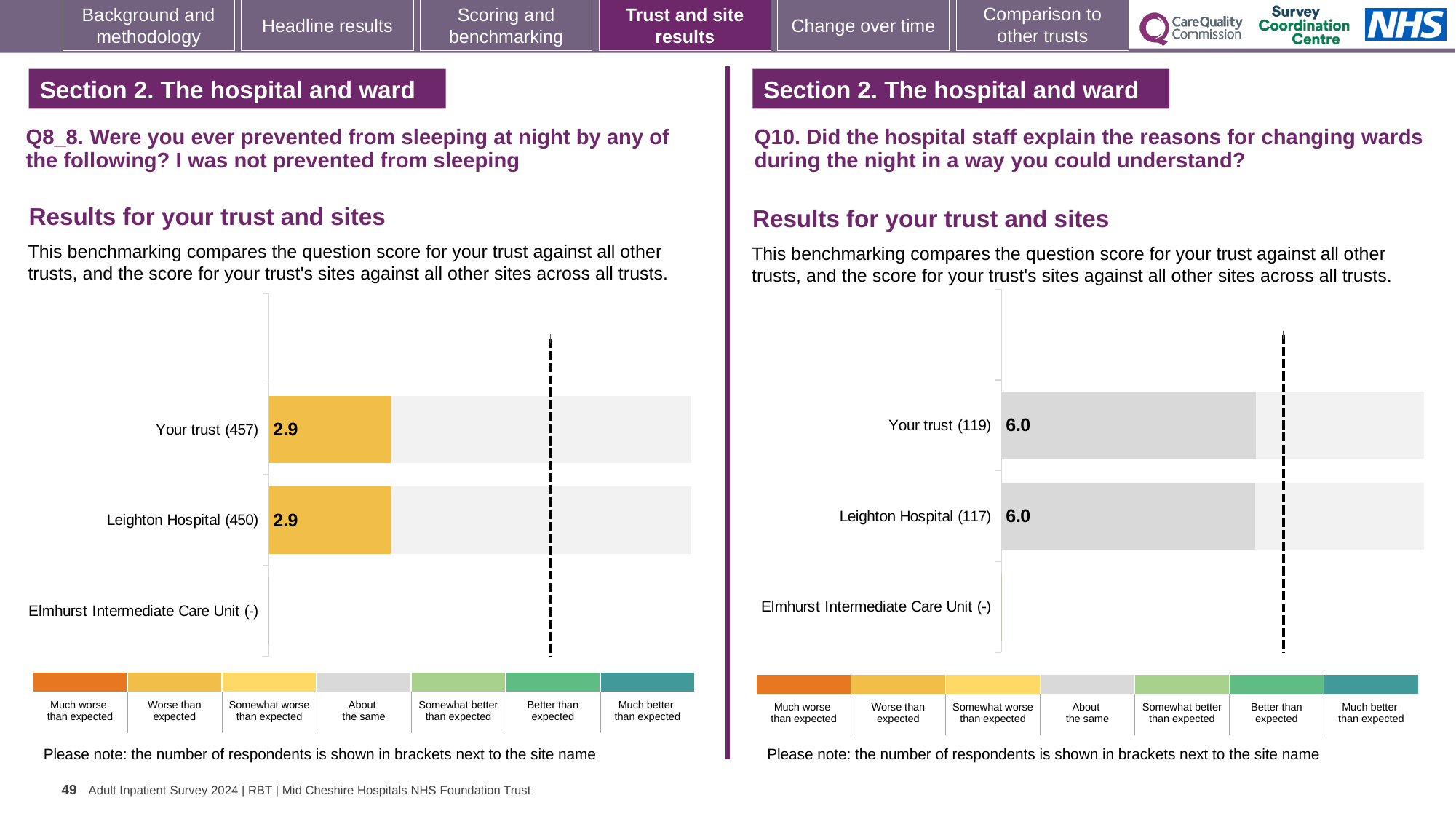
In the left chart (Q8_8), what is the score for Your trust (457)? 2.9 In the left chart (Q8_8), how many sites or categories are listed on the vertical axis? 3 In the right chart (Q10), what is the score for Your trust (119)? 6.0 In the right chart (Q10), what is the score for Leighton Hospital (117)? 6.0 In the right chart (Q10), according to the colour key, which benchmark category does the grey bar colour for Your trust (119) represent? About the same In the left chart (Q8_8), what is the score for Leighton Hospital (450)? 2.9 In the right chart (Q10), how many respondents are shown in brackets for Leighton Hospital? 117 In the right chart (Q10), how many sites or categories are listed on the vertical axis? 3 In the left chart (Q8_8), what is the difference between the score for Your trust (457) and Leighton Hospital (450)? 0.0 In the left chart (Q8_8), which category has no bar plotted? Elmhurst Intermediate Care Unit (-) What kind of chart is used in the left chart (Q8_8)? Bar chart